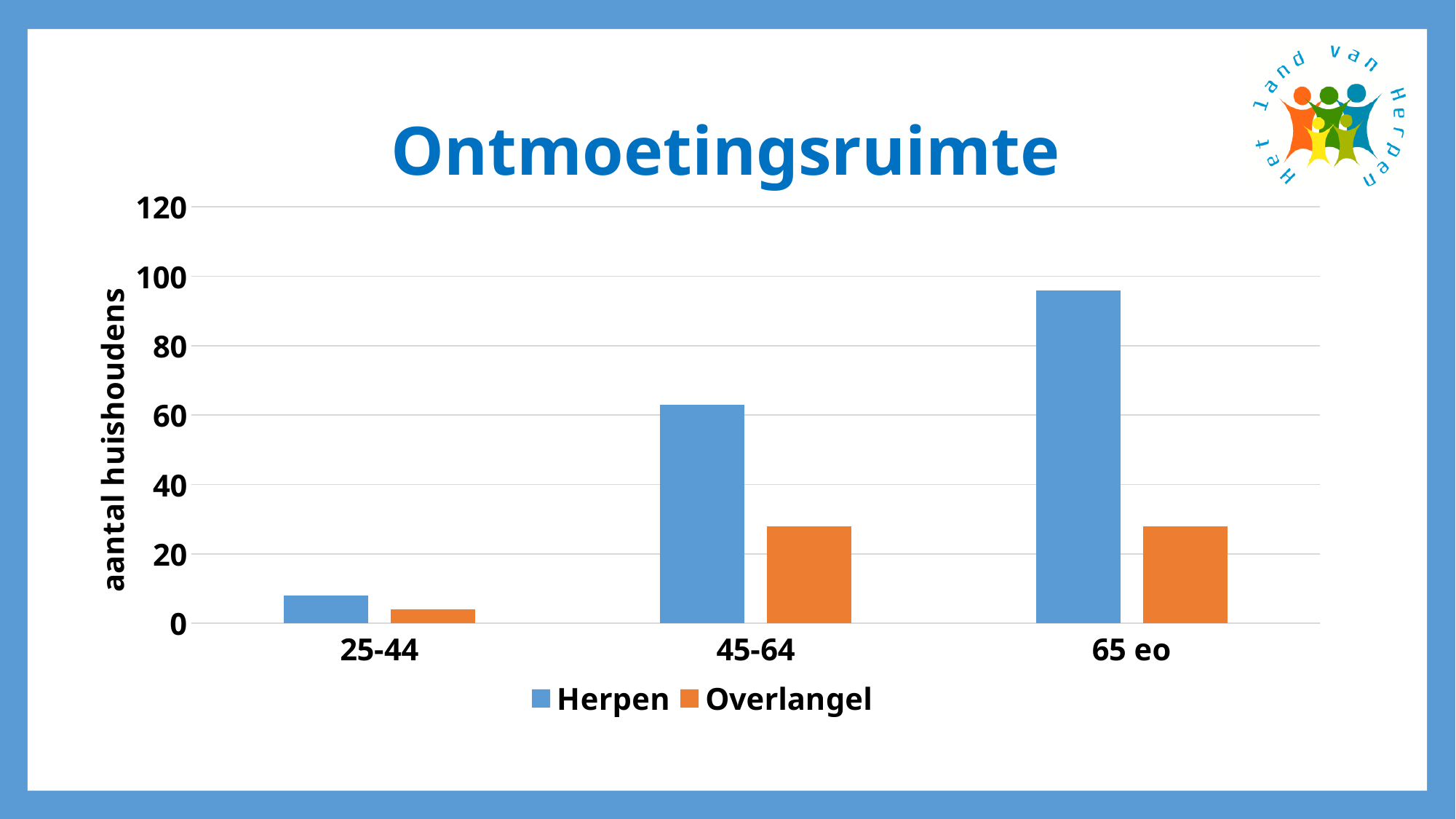
How many series does the legend list? 2 What is the label on the vertical axis? aantal huishoudens Is the value for Herpen in the 45-64 category greater or less than 60? greater Do the values for Herpen rise or fall from 25-44 to 65 eo? rise What kind of chart is shown on the slide? bar chart Which age category has the lowest value for Overlangel? 25-44 Which age category has the lowest value for Herpen? 25-44 Is the value for Herpen in the 65 eo category greater or less than 80? greater Which is larger in the 65 eo category, Herpen or Overlangel? Herpen Is the value for Overlangel in the 45-64 category greater or less than 40? less Which age category has the highest value for Herpen? 65 eo How many age categories are shown on the x axis? 3